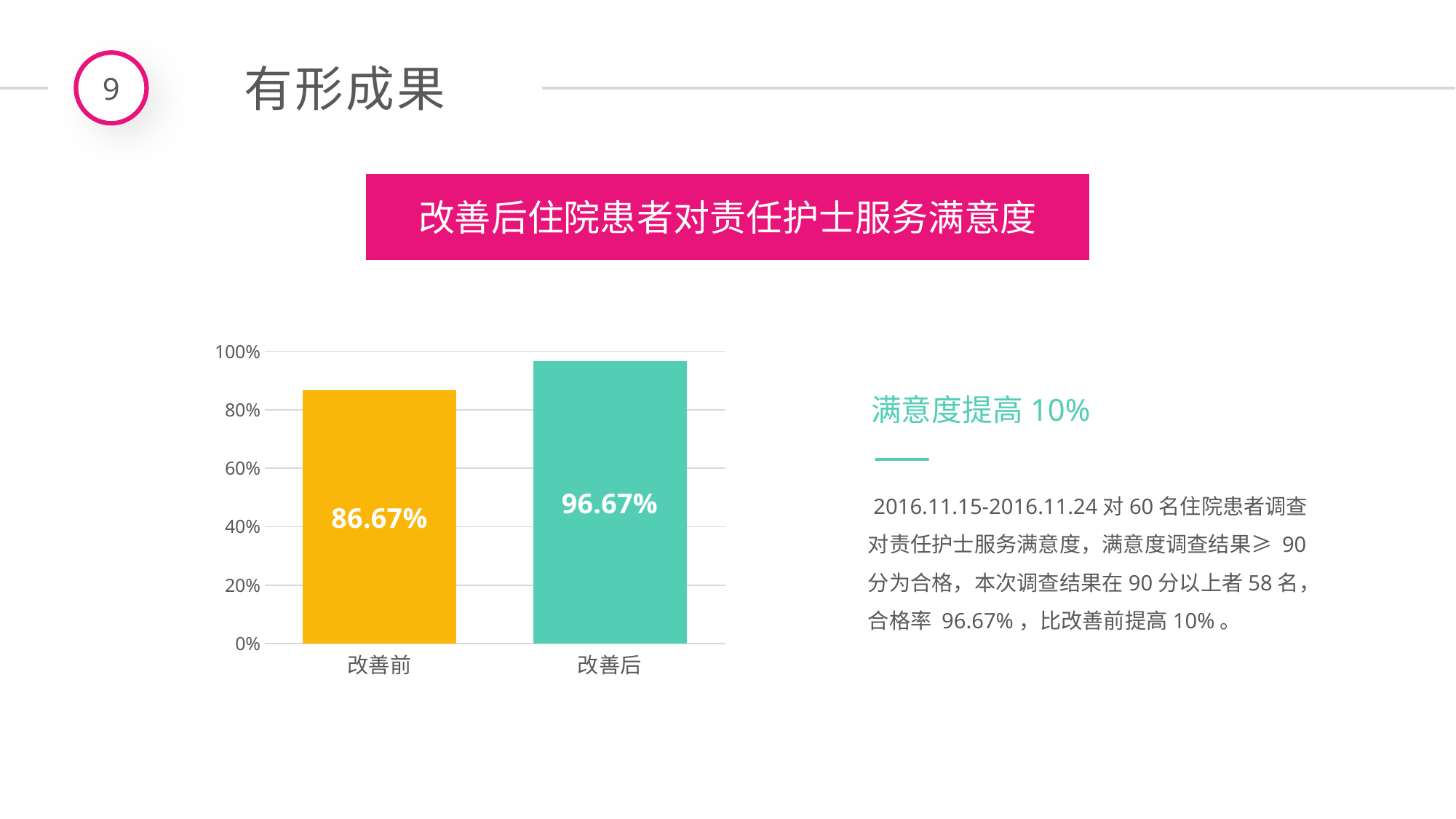
What is the difference between the values for 改善后 and 改善前? 10% Is the value for 改善后 greater or less than 100%? less What is the value for 改善后? 96.67% How many categories are shown on the x axis? 2 Which is larger, the value for 改善前 or the value for 改善后? 改善后 What colour is the bar for 改善后? teal (green) Which category has the highest value? 改善后 Do the values rise or fall from 改善前 to 改善后? rise What kind of chart is shown on the slide? bar chart What is the value for 改善前? 86.67% Which category has the lowest value? 改善前 Is the value for 改善前 greater or less than 80%? greater